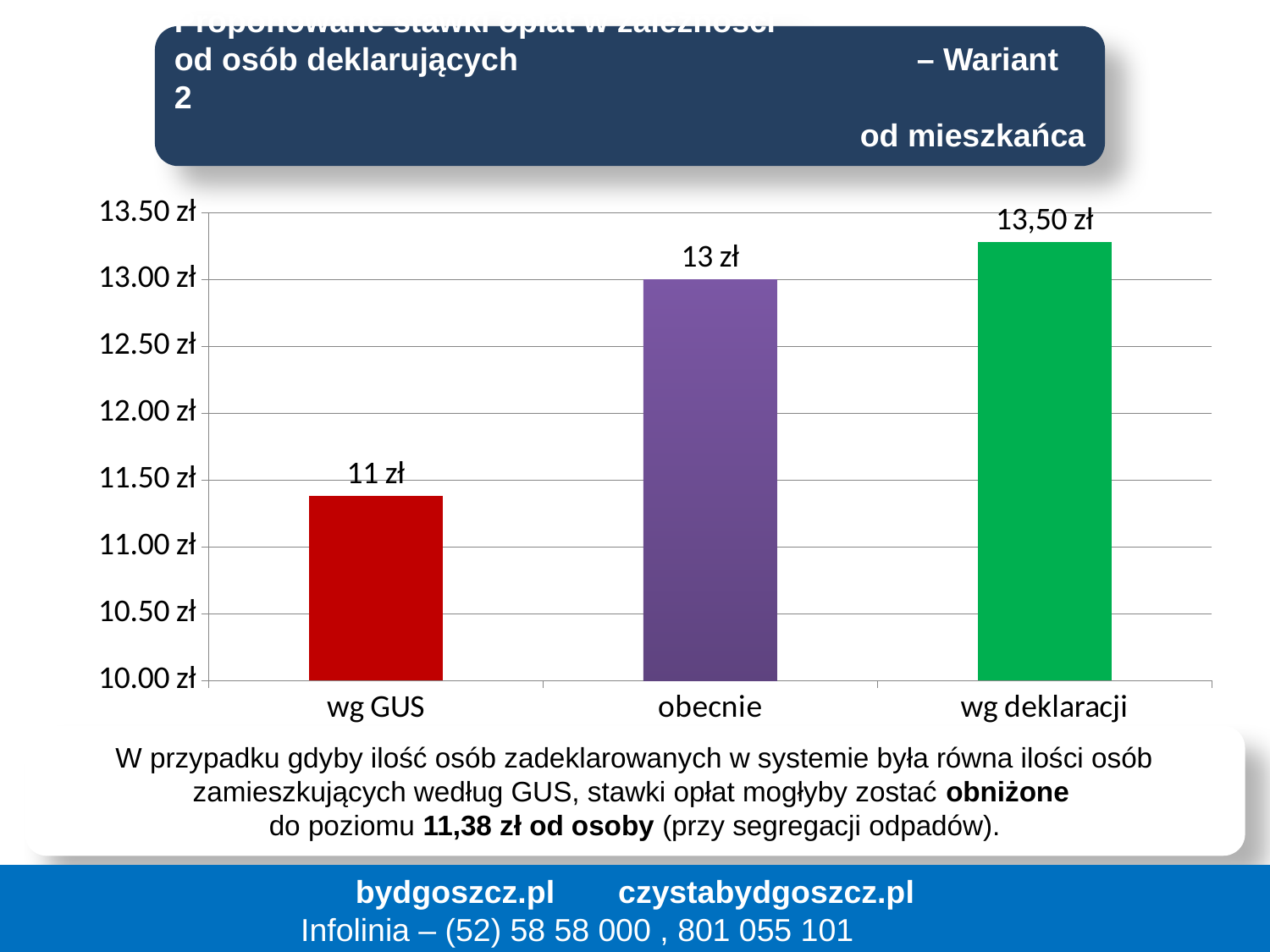
Which is larger, the value for 'obecnie' or the value for 'wg GUS'? obecnie What colour is the bar for 'wg deklaracji'? green What value is labelled on the bar for 'wg GUS'? 11 zł What kind of chart is shown on the slide? bar chart Which category has the highest bar? wg deklaracji Which category has the lowest bar? wg GUS How many categories are shown on the x axis of the chart? 3 What value is labelled on the bar for 'obecnie'? 13 zł Do the bar values rise or fall from left to right along the x axis? rise What value is labelled on the bar for 'wg deklaracji'? 13,50 zł Is the value for 'obecnie' greater or less than 12.50 zł? greater Is the value for 'wg GUS' greater or less than 12.00 zł? less